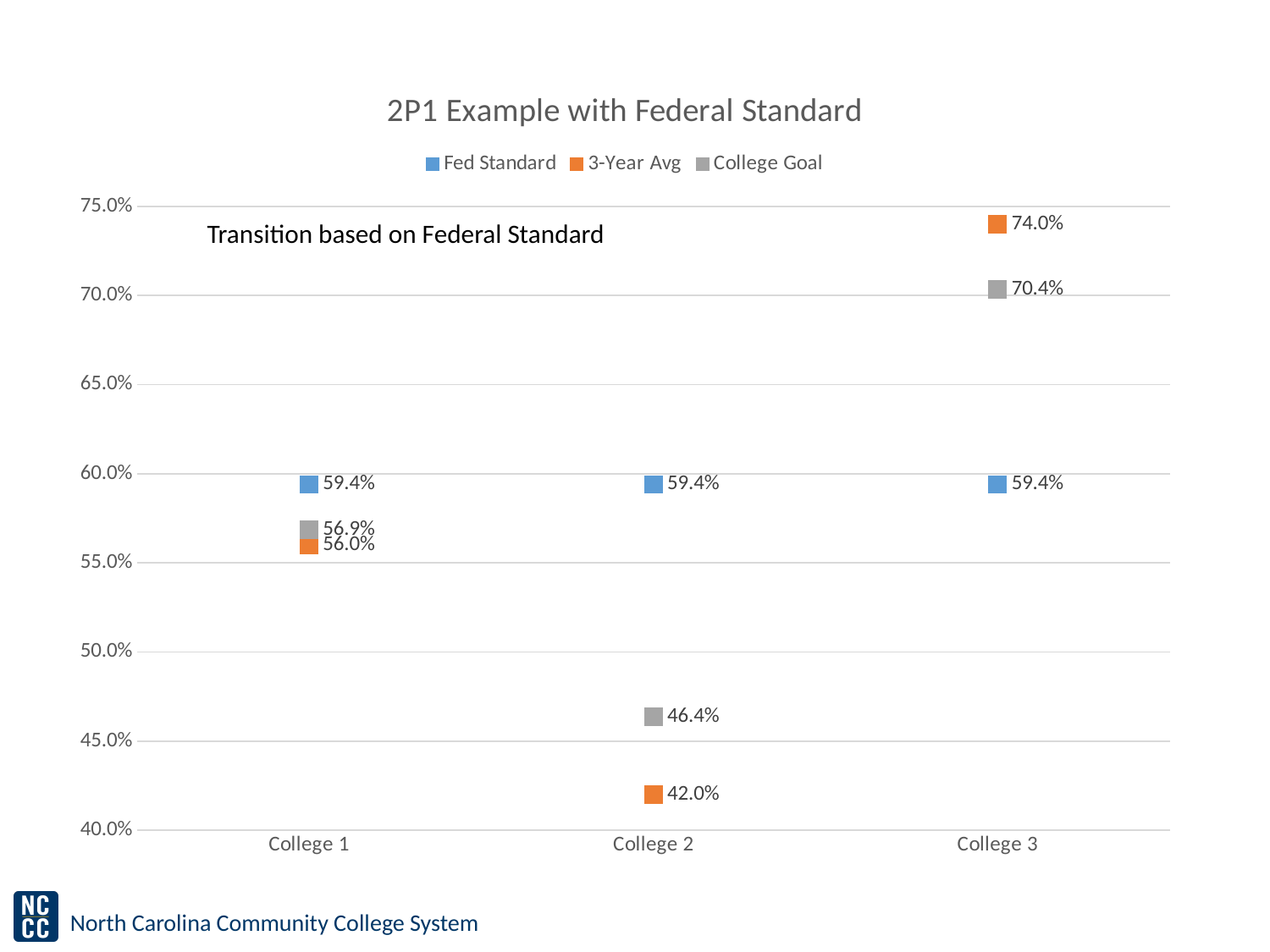
Which college has the highest 3-Year Avg? College 3 What is the difference between the 3-Year Avg for College 3 and College 2? 32.0% What is the 3-Year Avg value for College 1? 56.0% Which college has the lowest College Goal? College 2 What is the 3-Year Avg value for College 3? 74.0% Which is larger for College 1: the College Goal or the 3-Year Avg? College Goal What is the College Goal value for College 2? 46.4% What is the Fed Standard value for College 1? 59.4% How many series does the legend list? 3 Which colour represents the Fed Standard series? Blue What is the title of the chart? 2P1 Example with Federal Standard How many colleges are shown on the x axis? 3